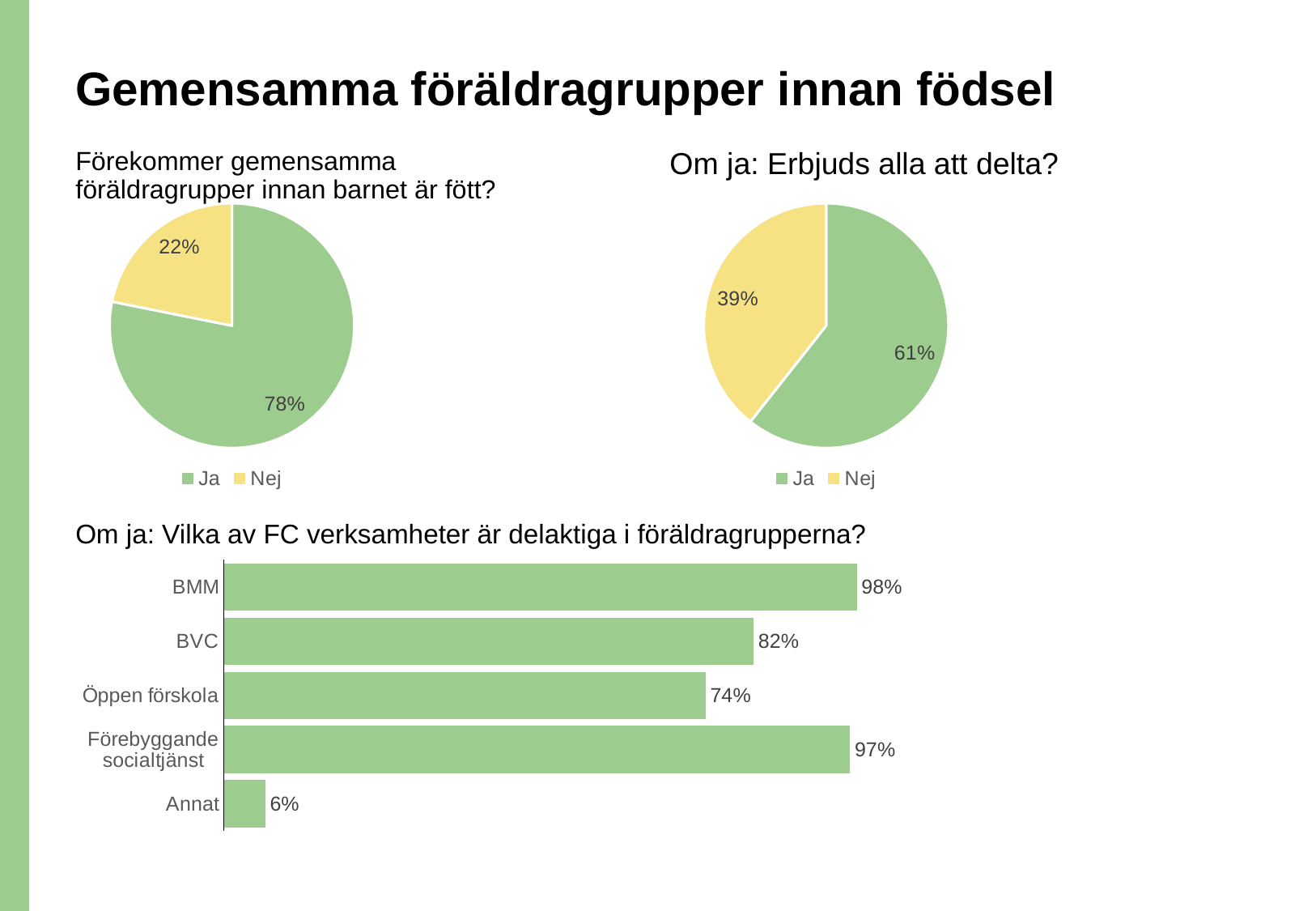
In the top-right pie chart 'Om ja: Erbjuds alla att delta?', what share is 'Nej'? 39% In the bottom bar chart 'Om ja: Vilka av FC verksamheter är delaktiga i föräldragrupperna?', which category has the lowest value? Annat In the top-left pie chart 'Förekommer gemensamma föräldragrupper innan barnet är fött?', what share is 'Nej'? 22% In the bottom bar chart 'Om ja: Vilka av FC verksamheter är delaktiga i föräldragrupperna?', what is the value for 'BVC'? 82% What kind of chart is the bottom chart 'Om ja: Vilka av FC verksamheter är delaktiga i föräldragrupperna?'? Bar chart In the bottom bar chart 'Om ja: Vilka av FC verksamheter är delaktiga i föräldragrupperna?', what is the difference between 'BVC' and 'Öppen förskola'? 8% In the top-right pie chart 'Om ja: Erbjuds alla att delta?', what is the difference between the 'Ja' and 'Nej' shares? 22% In the top-left pie chart 'Förekommer gemensamma föräldragrupper innan barnet är fött?', how many entries does the legend list? 2 In the bottom bar chart 'Om ja: Vilka av FC verksamheter är delaktiga i föräldragrupperna?', how many categories are shown? 5 In the top-left pie chart 'Förekommer gemensamma föräldragrupper innan barnet är fött?', what share is 'Ja'? 78% In the top-right pie chart 'Om ja: Erbjuds alla att delta?', which slice is larger, 'Ja' or 'Nej'? Ja In the bottom bar chart 'Om ja: Vilka av FC verksamheter är delaktiga i föräldragrupperna?', which category has the highest value? BMM